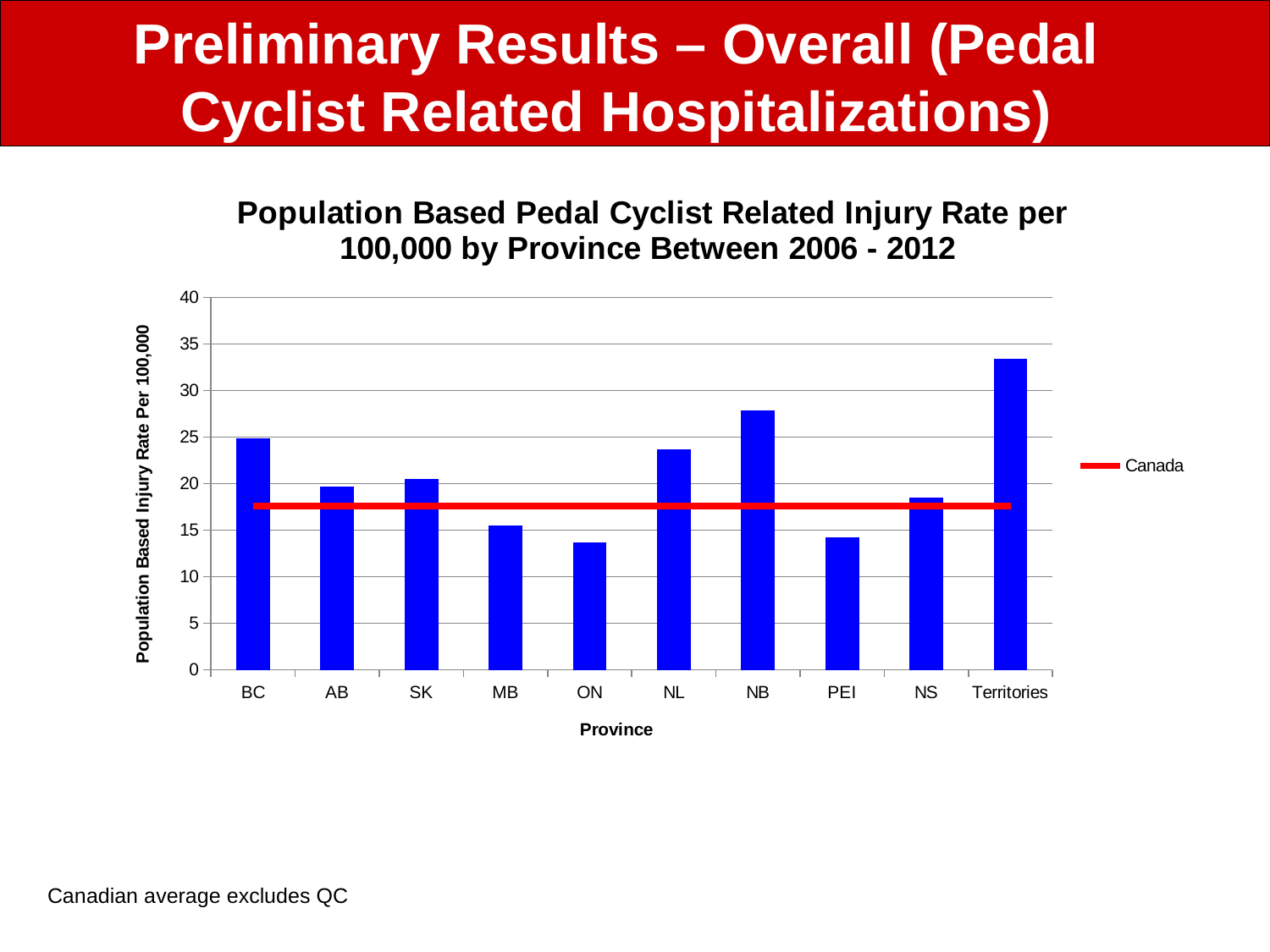
Which has the higher injury rate, BC or AB? BC How many entries does the chart legend list? 1 Is the value for ON greater or less than 15? less Which province or region has the highest pedal cyclist related injury rate? Territories Is the value for BC greater or less than 20? greater How many provinces/regions are shown on the x axis of the chart? 10 What does the red horizontal line on the chart represent, according to the legend? Canada What kind of chart is shown on the slide? bar chart Is the value for Territories greater or less than 30? greater Which has the higher injury rate, NB or NL? NB